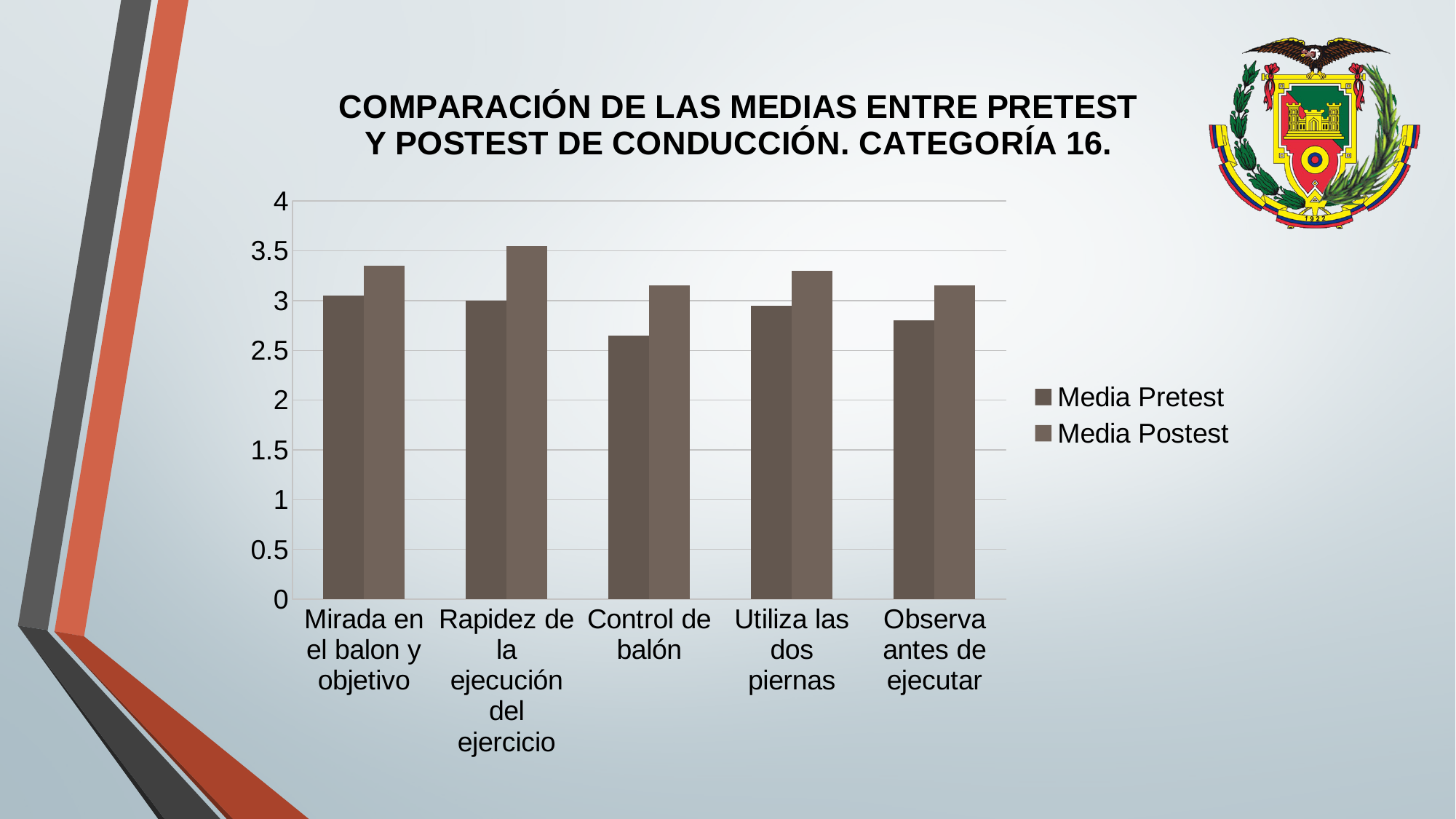
Is the Media Postest value for Rapidez de la ejecución del ejercicio greater or less than 3.5? greater What is the title of the chart? COMPARACIÓN DE LAS MEDIAS ENTRE PRETEST Y POSTEST DE CONDUCCIÓN. CATEGORÍA 16. For Rapidez de la ejecución del ejercicio, which is larger: Media Pretest or Media Postest? Media Postest How many series does the legend list? 2 Is the Media Postest value for Utiliza las dos piernas greater or less than 3? greater Is the Media Pretest value for Observa antes de ejecutar greater or less than 3? less How many categories are shown on the x axis of the chart? 5 Which category has the lowest Media Pretest value? Control de balón Which category has the highest Media Postest value? Rapidez de la ejecución del ejercicio For Control de balón, which is larger: Media Pretest or Media Postest? Media Postest What kind of chart is shown on the slide? bar chart